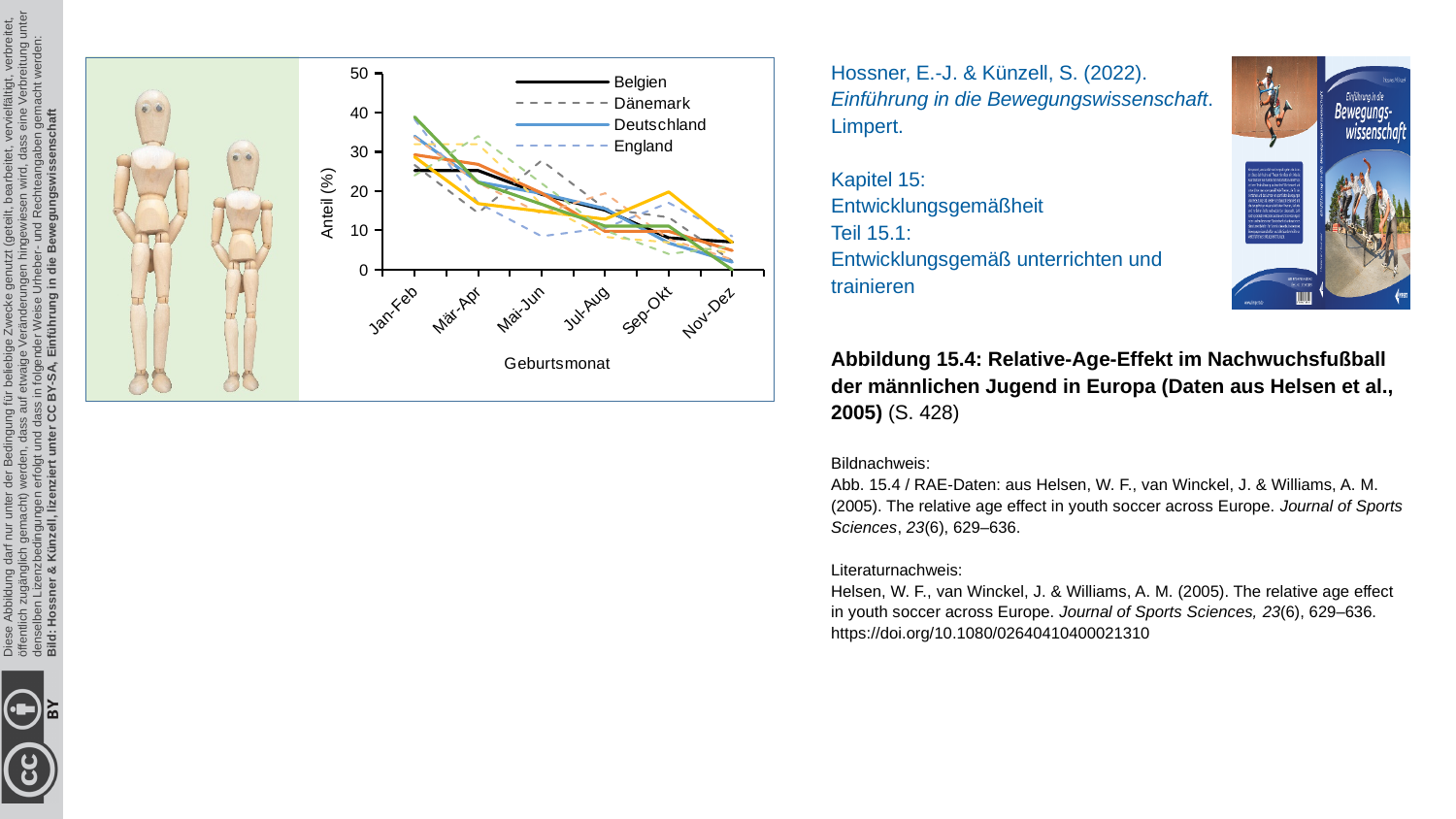
Is the value for Belgien at Nov-Dez greater or less than 10? less What is the label of the y axis of the chart? Anteil (%) Is the value for Belgien at Jan-Feb greater or less than 20? greater What kind of chart is shown on the slide? line chart Do the values in the chart generally rise or fall from Jan-Feb to Nov-Dez? fall Which series are named in the chart's legend? Belgien, Dänemark, Deutschland, England How many series does the chart's legend list? 4 What is the highest value shown on the y axis of the chart? 50 Is the value for Belgien at Jan-Feb greater or less than 30? less Is the value for Belgien at Jan-Feb greater or less than the value for Belgien at Nov-Dez? greater How many birth-month categories are shown on the x axis of the chart? 6